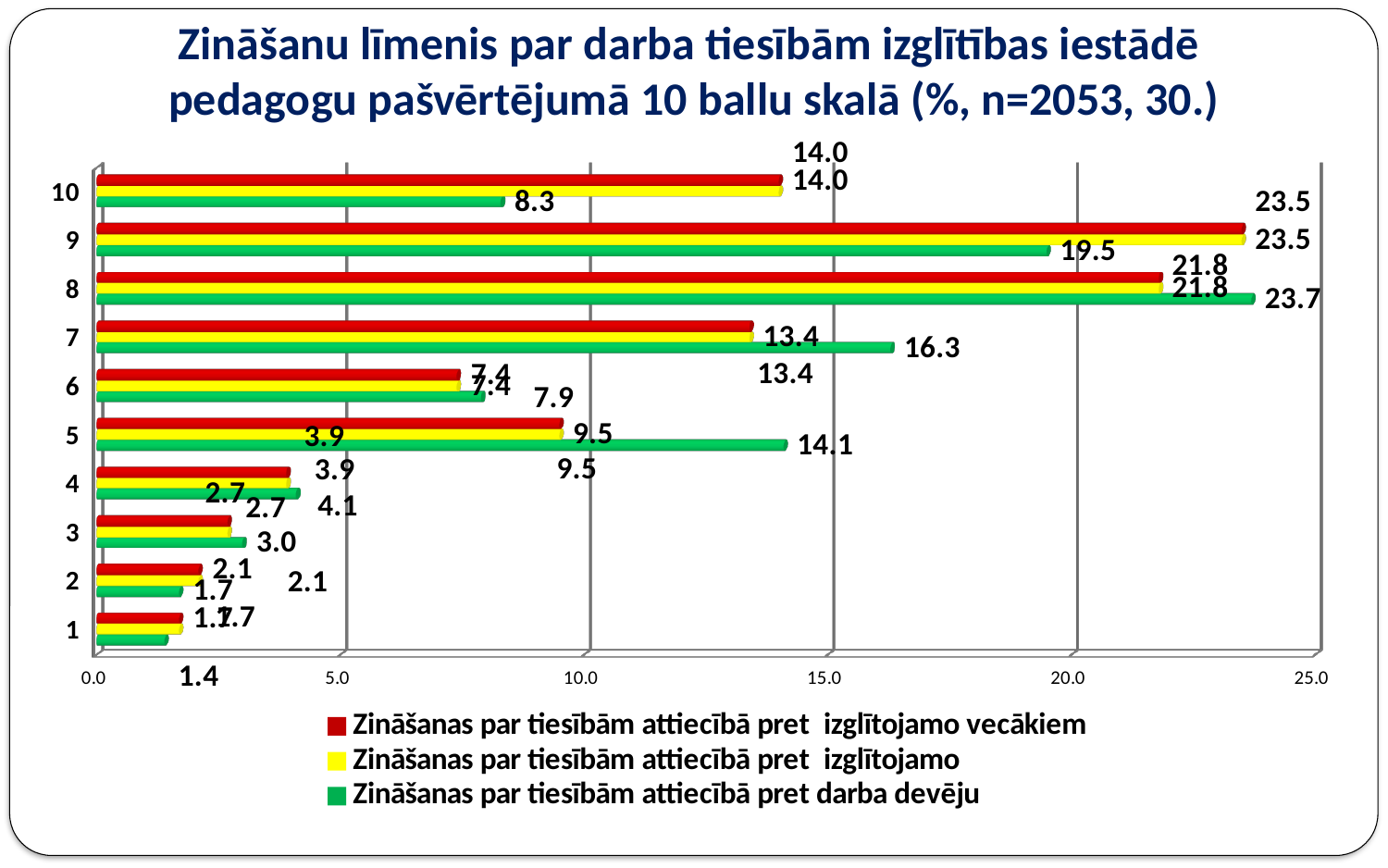
Which category has the highest value in the 'Zināšanas par tiesībām attiecībā pret izglītojamo vecākiem' series? 9 For category 7, which is larger: the 'Zināšanas par tiesībām attiecībā pret darba devēju' value or the 'Zināšanas par tiesībām attiecībā pret izglītojamo' value? Zināšanas par tiesībām attiecībā pret darba devēju Which category has the lowest value in the 'Zināšanas par tiesībām attiecībā pret darba devēju' series? 1 What is the value for category 9 in the 'Zināšanas par tiesībām attiecībā pret darba devēju' series? 19.5 What kind of chart is shown on the slide? bar chart Which category has the highest value in the 'Zināšanas par tiesībām attiecībā pret darba devēju' series? 8 What is the difference between the 'Zināšanas par tiesībām attiecībā pret izglītojamo vecākiem' value and the 'Zināšanas par tiesībām attiecībā pret darba devēju' value for category 9? 4.0 How many categories are shown on the vertical axis of the chart? 10 Is the value for category 5 in the 'Zināšanas par tiesībām attiecībā pret darba devēju' series greater or less than 10.0? greater How many series does the legend list? 3 What is the value for category 10 in the 'Zināšanas par tiesībām attiecībā pret izglītojamo vecākiem' series? 14.0 What is the value for category 8 in the 'Zināšanas par tiesībām attiecībā pret darba devēju' series? 23.7